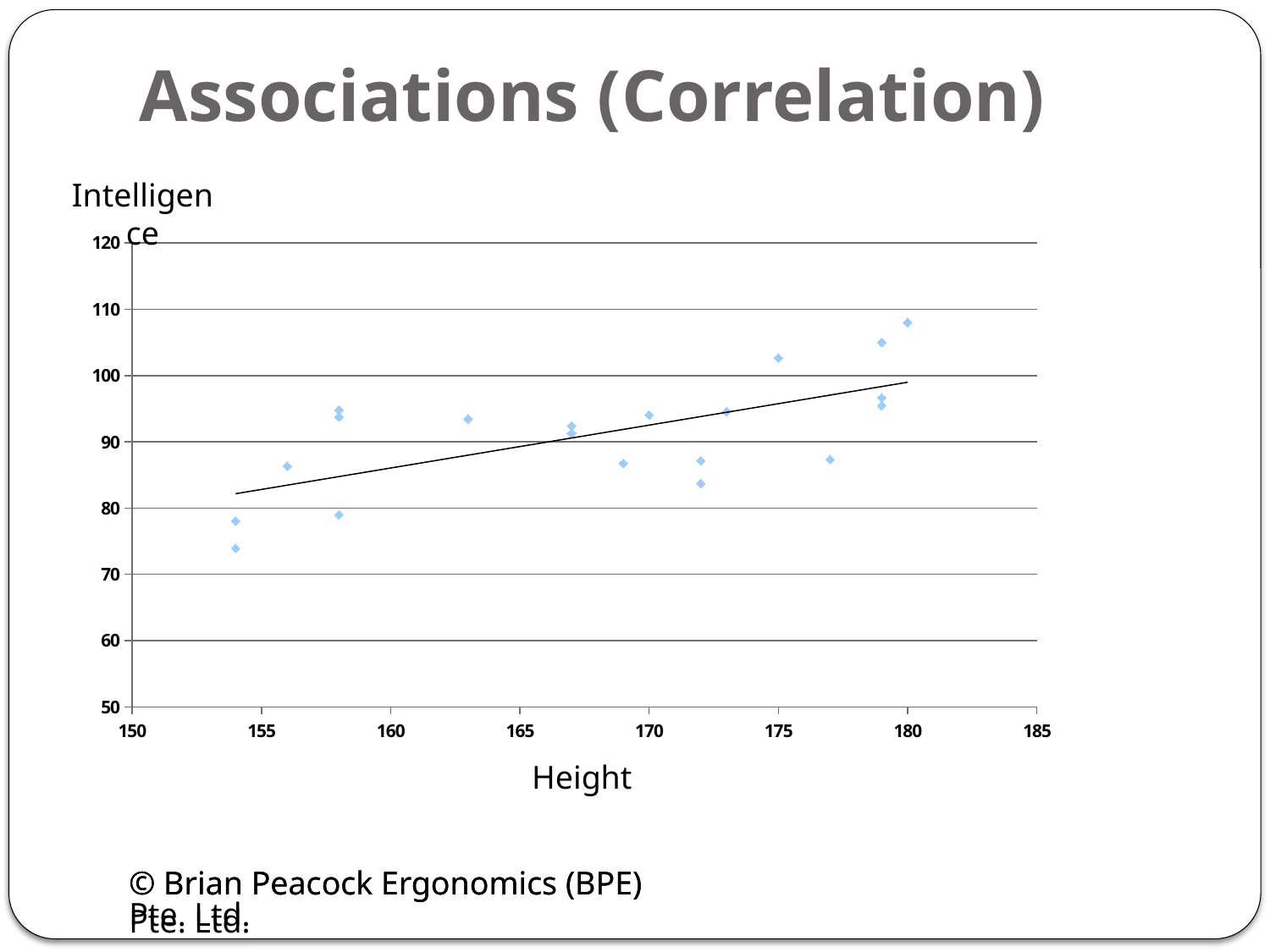
What is the title of the chart on the slide? Associations (Correlation) Is the Intelligence value for the point at Height 180 greater or less than 100? greater Is the Intelligence value for the point at Height 177 greater or less than 90? less Is the Intelligence value for the point at Height 175 greater or less than 100? greater Which has the higher Intelligence value: the point at Height 180 or the point at Height 177? the point at Height 180 What is the label of the horizontal axis? Height At which Height does the point with the highest Intelligence value appear? 180 What kind of chart is shown on the slide? scatter plot At which Height does the point with the lowest Intelligence value appear? 154 Do the Intelligence values generally rise or fall as Height increases along the x axis? rise